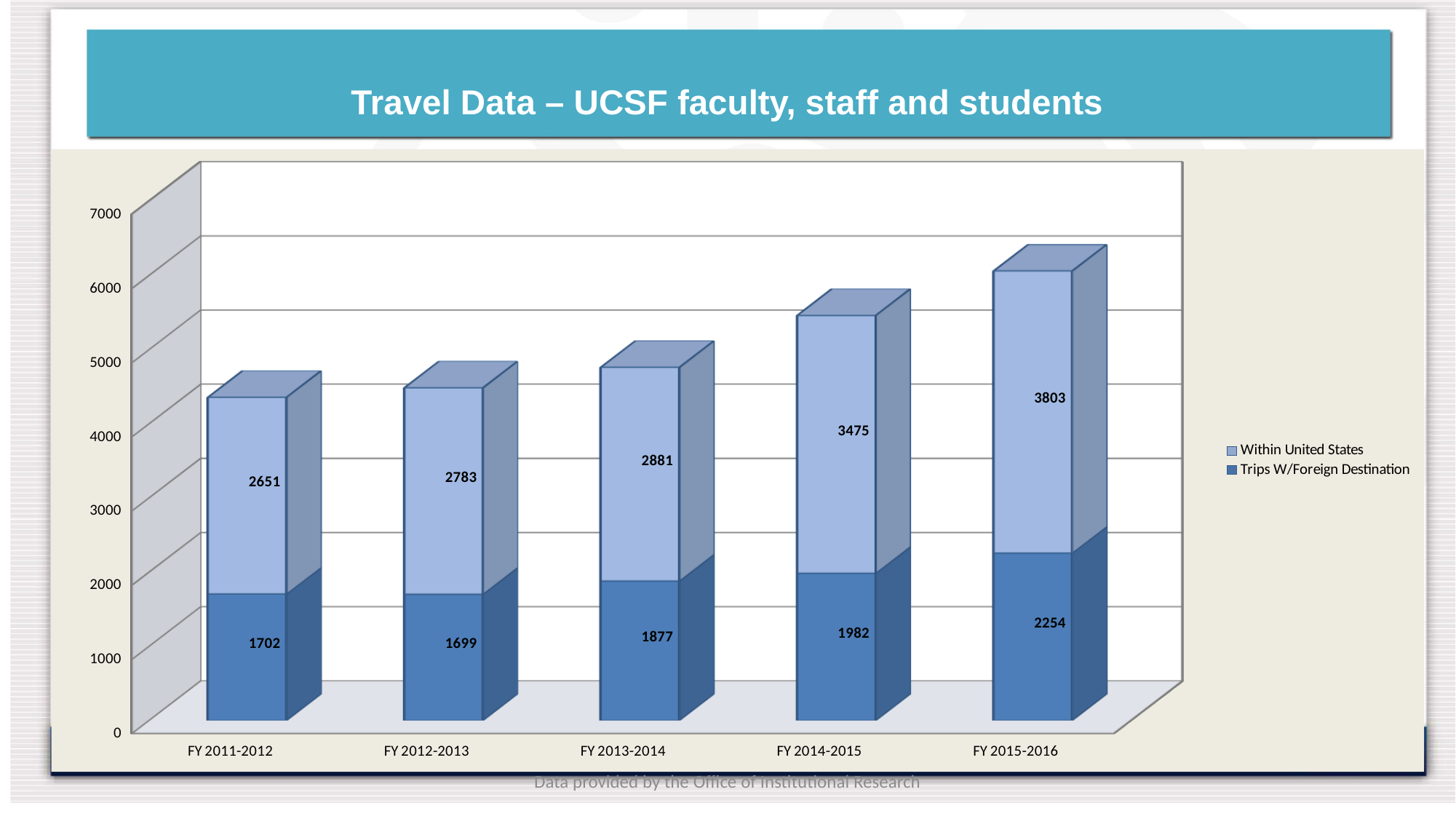
How many fiscal years are shown on the x axis? 5 What is the total of the stacked bar for FY 2011-2012? 4353 What is the value for Within United States in FY 2013-2014? 2881 Which fiscal year has the lowest value for Trips W/Foreign Destination? FY 2012-2013 Which fiscal year has the highest value for Within United States? FY 2015-2016 What is the difference between the Within United States values for FY 2015-2016 and FY 2014-2015? 328 How many series does the legend list? 2 Which is larger: Trips W/Foreign Destination in FY 2013-2014 or in FY 2014-2015? FY 2014-2015 What is the value for Trips W/Foreign Destination in FY 2015-2016? 2254 Do the Within United States values rise or fall from FY 2011-2012 to FY 2015-2016? Rise What is the total of the stacked bar for FY 2015-2016? 6057 What kind of chart is shown on the slide? Stacked bar chart